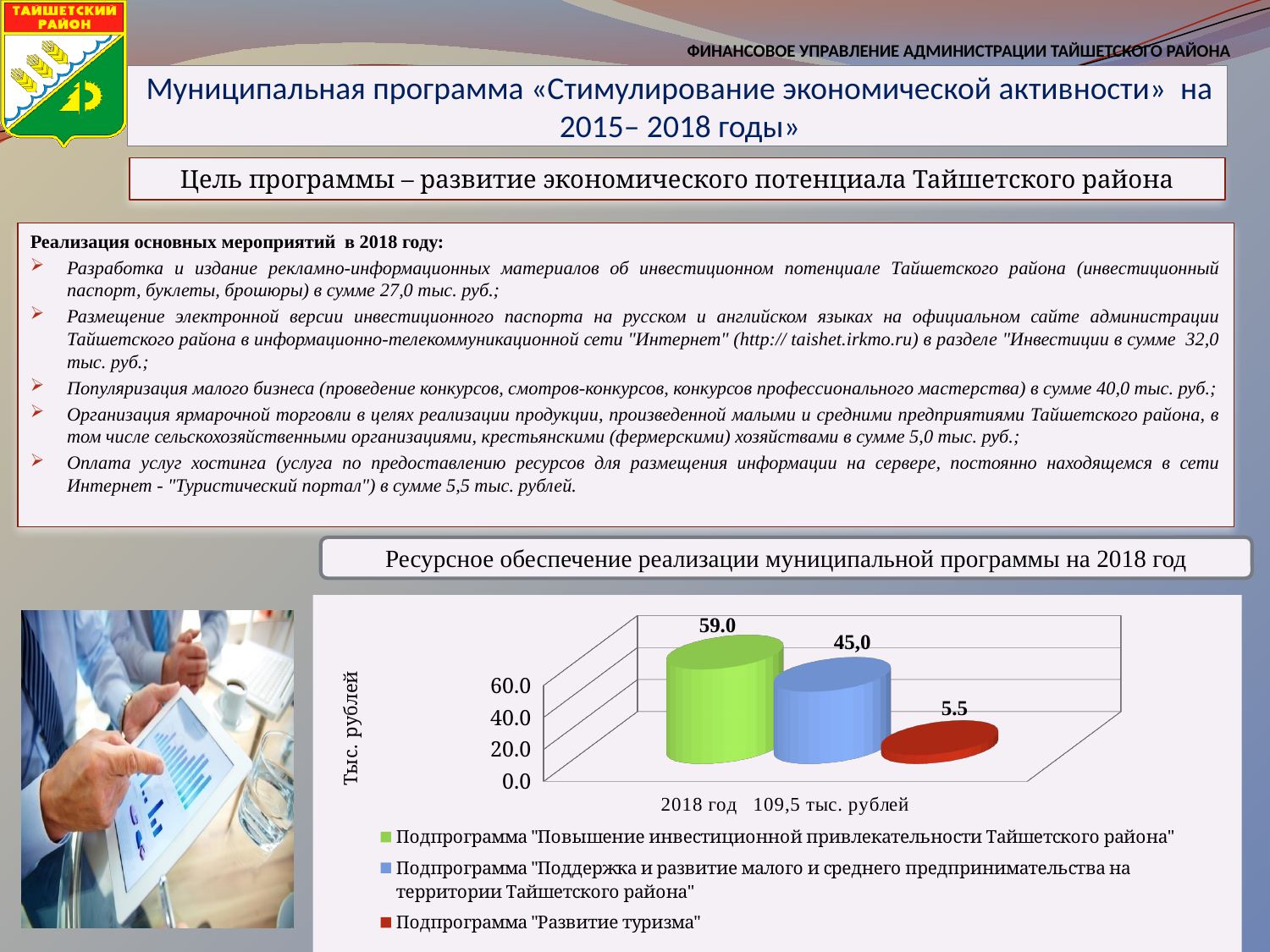
How many series does the chart legend list? 3 What unit is shown on the vertical axis of the chart? Тыс. рублей Which is larger: the value for "Поддержка и развитие малого и среднего предпринимательства" or the value for "Развитие туризма"? Поддержка и развитие малого и среднего предпринимательства What type of chart is shown on the slide? bar chart Which subprogram has the highest value in the chart? Подпрограмма "Повышение инвестиционной привлекательности Тайшетского района" What is the value for the subprogram "Развитие туризма"? 5.5 What is the total of the three subprogram values shown for 2018 год? 109,5 тыс. рублей What is the difference between the values for "Повышение инвестиционной привлекательности Тайшетского района" and "Поддержка и развитие малого и среднего предпринимательства"? 14.0 What is the value for the subprogram "Повышение инвестиционной привлекательности Тайшетского района"? 59.0 What is the difference between the values for "Поддержка и развитие малого и среднего предпринимательства" and "Развитие туризма"? 39.5 What is the value for the subprogram "Поддержка и развитие малого и среднего предпринимательства на территории Тайшетского района"? 45,0 Which subprogram has the lowest value in the chart? Подпрограмма "Развитие туризма"